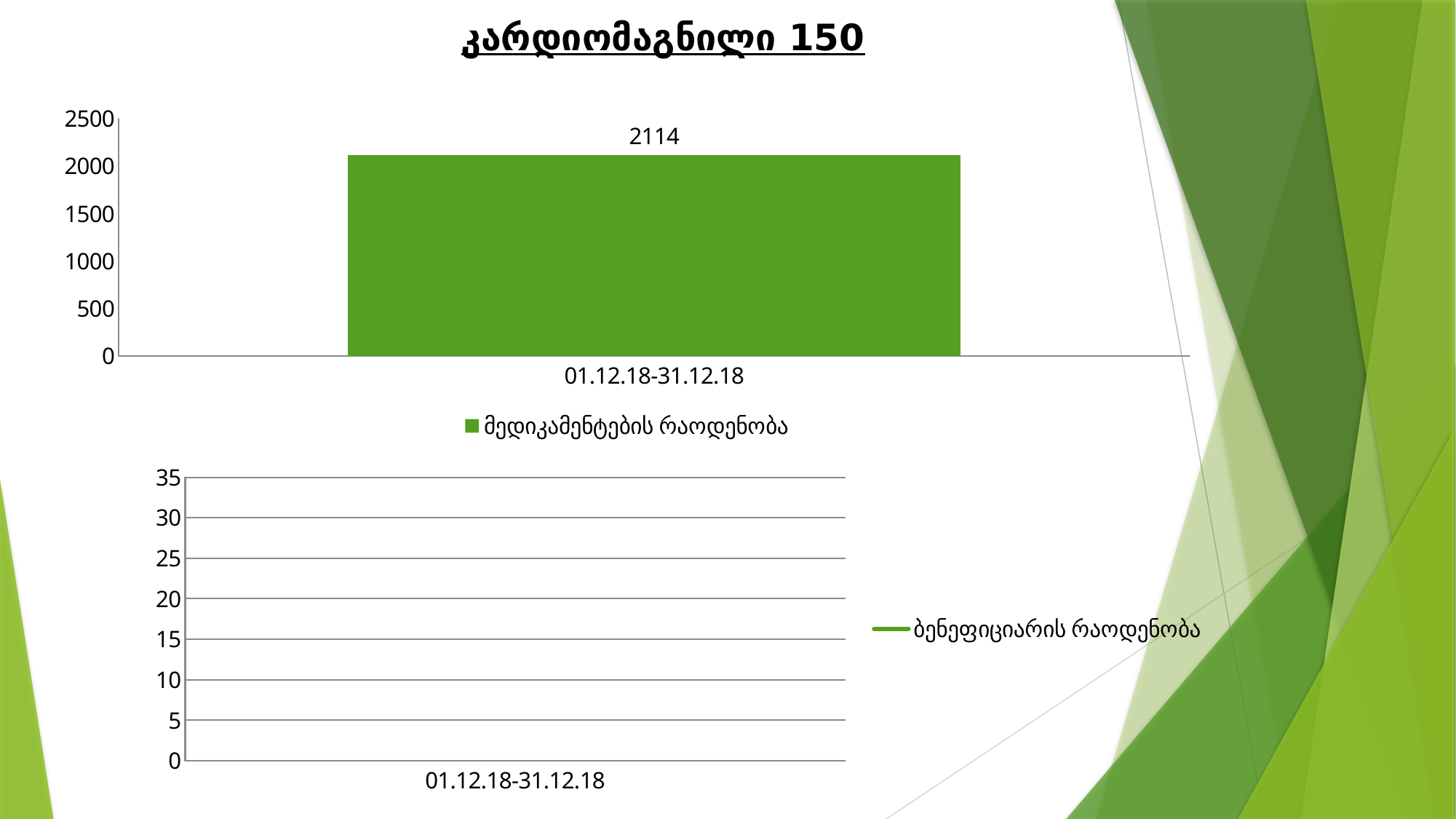
What kind of chart is the top chart on the slide? bar chart In the top chart, what is the value for 01.12.18-31.12.18? 2114 What is the legend entry of the top chart? მედიკამენტების რაოდენობა In the top chart, is the value for 01.12.18-31.12.18 greater or less than 2000? greater How many series does the legend of the top chart list? 1 How many series does the legend of the bottom chart list? 1 How many categories are shown on the x axis of the bottom chart? 1 In the top chart, is the value for 01.12.18-31.12.18 greater or less than 2500? less What is the title shown above the charts on the slide? კარდიომაგნილი 150 How many bars are plotted in the top chart? 1 What kind of chart is the bottom chart on the slide? line chart